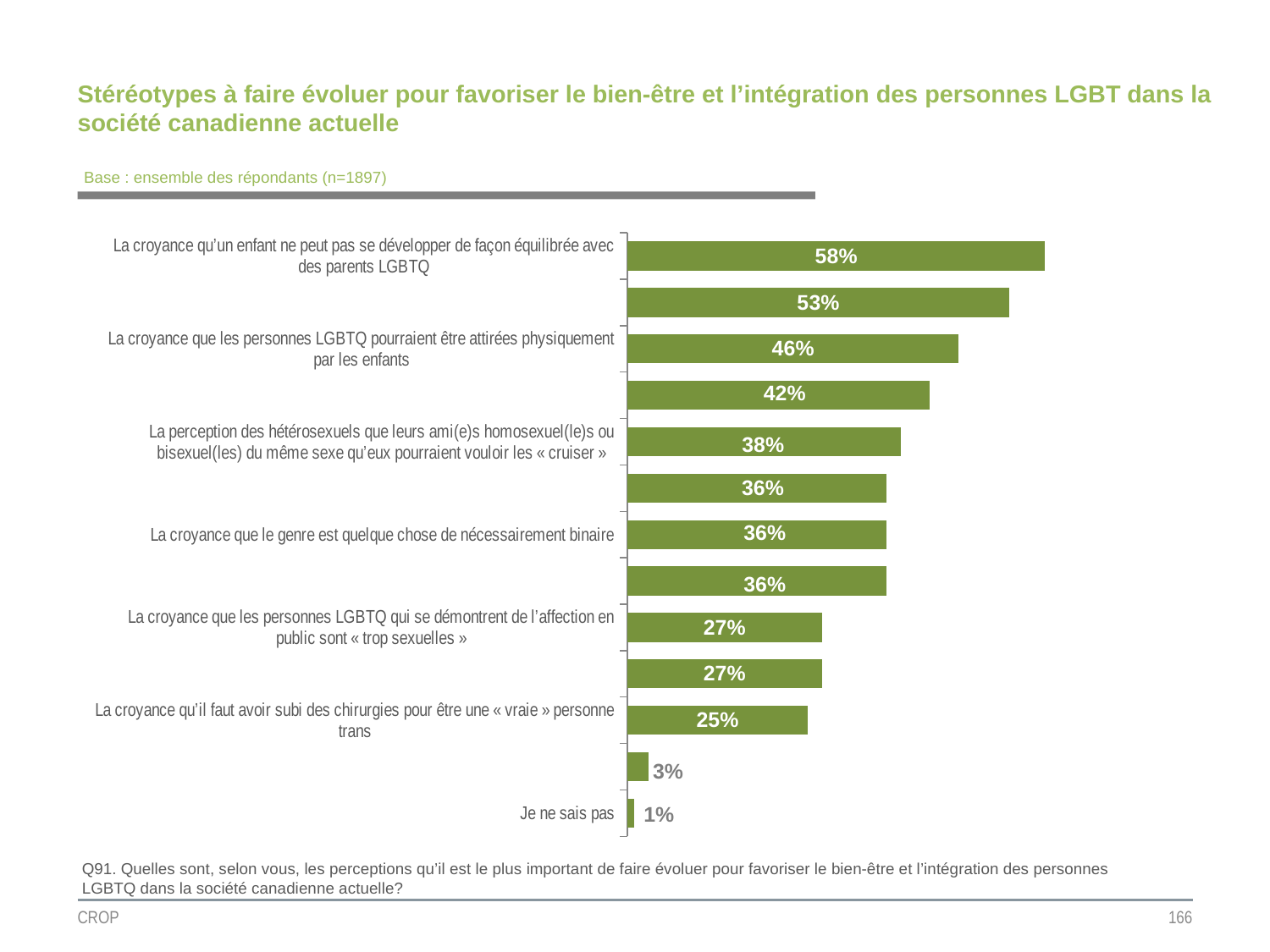
What percentage is shown for "Je ne sais pas"? 1% What percentage is shown for "La croyance qu'il faut avoir subi des chirurgies pour être une « vraie » personne trans"? 25% What percentage is shown for "La croyance que les personnes LGBTQ pourraient être attirées physiquement par les enfants"? 46% Which category has the highest value in the chart? La croyance qu'un enfant ne peut pas se développer de façon équilibrée avec des parents LGBTQ What is the difference in percentage points between "La croyance qu'un enfant ne peut pas se développer de façon équilibrée avec des parents LGBTQ" and "La croyance que les personnes LGBTQ pourraient être attirées physiquement par les enfants"? 12 percentage points How many bars are plotted in the chart? 13 Do the bar values increase or decrease from the top of the chart to the bottom? Decrease What percentage is shown for "La croyance que le genre est quelque chose de nécessairement binaire"? 36% Which category has the lowest value in the chart? Je ne sais pas Which is larger: the value for "La perception des hétérosexuels que leurs ami(e)s homosexuel(le)s ou bisexuel(les) du même sexe qu'eux pourraient vouloir les « cruiser »" or the value for "La croyance que les personnes LGBTQ qui se démontrent de l'affection en public sont « trop sexuelles »"? La perception des hétérosexuels que leurs ami(e)s homosexuel(le)s ou bisexuel(les) du même sexe qu'eux pourraient vouloir les « cruiser » What percentage is shown for "La croyance qu'un enfant ne peut pas se développer de façon équilibrée avec des parents LGBTQ"? 58% What kind of chart is shown on the slide? Bar chart